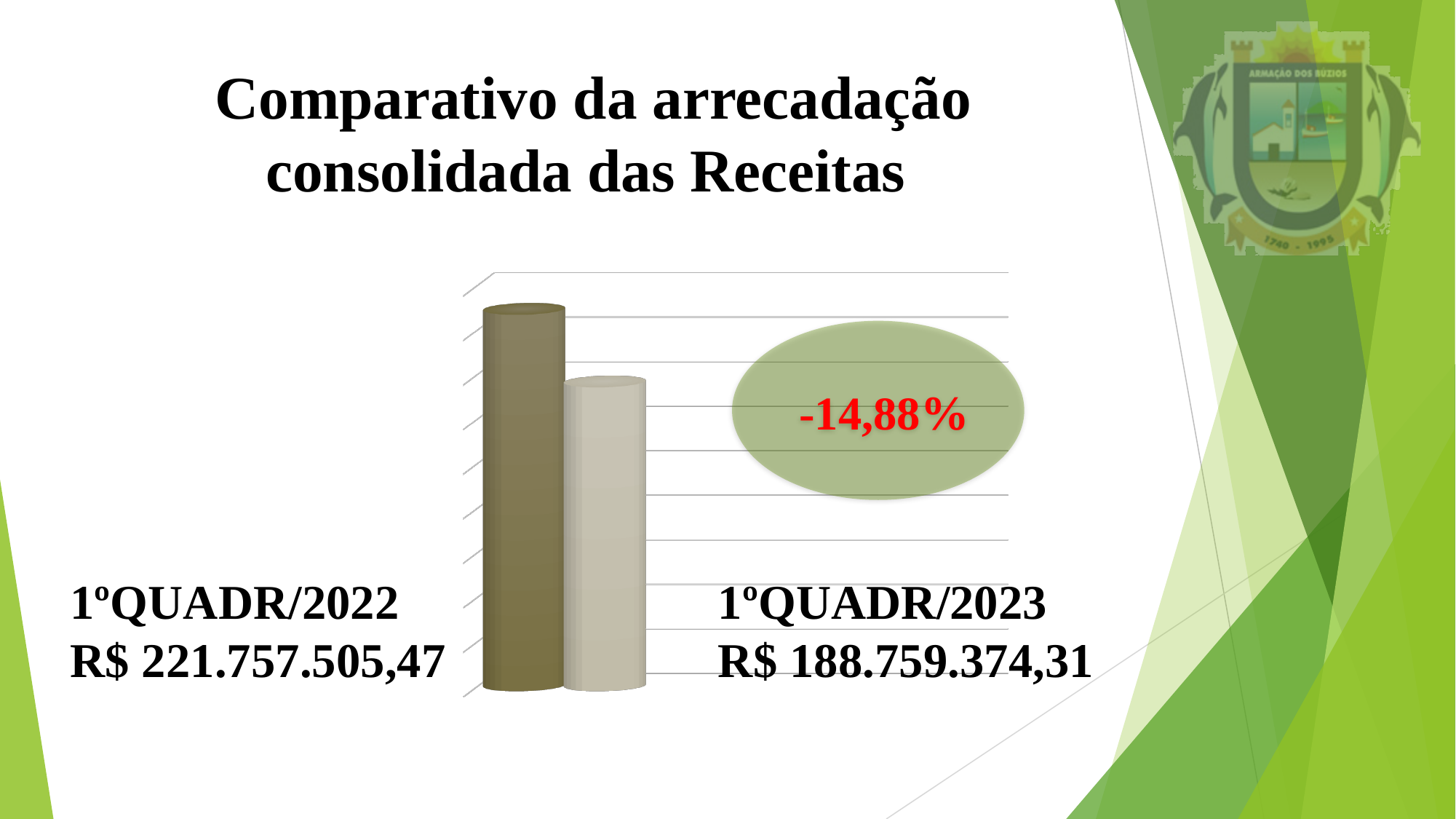
What is the title of the slide? Comparativo da arrecadação consolidada das Receitas What kind of chart is shown on the slide? Bar chart What is the difference between the values for 1ºQUADR/2022 and 1ºQUADR/2023? R$ 32.998.131,16 Which is larger, the value for 1ºQUADR/2022 or for 1ºQUADR/2023? 1ºQUADR/2022 How many bars are shown in the chart? 2 Do the values rise or fall from 1ºQUADR/2022 to 1ºQUADR/2023? Fall What is the value for 1ºQUADR/2022? R$ 221.757.505,47 Which period has the lowest value? 1ºQUADR/2023 What is the value for 1ºQUADR/2023? R$ 188.759.374,31 What percentage change is shown in the oval on the chart? -14,88% Which period has the highest value? 1ºQUADR/2022